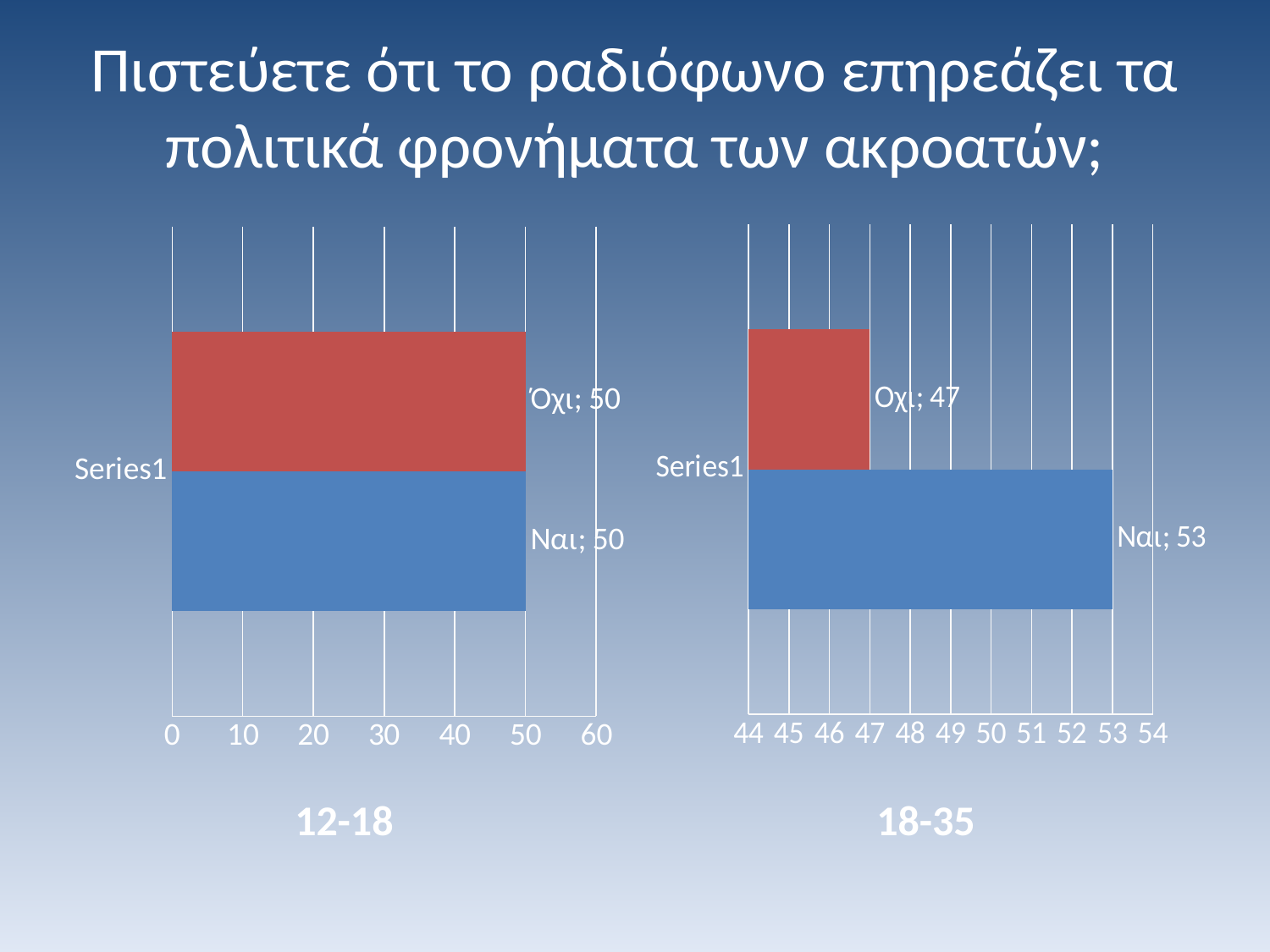
In the 18-35 chart, what is the value for Όχι? 47 In the 12-18 chart, what is the value for Ναι? 50 In the 18-35 chart, which category has the lowest value? Όχι What kind of chart is the 12-18 chart? Bar chart In the 18-35 chart, is the value for Όχι greater or less than 50? less In the 18-35 chart, what is the value for Ναι? 53 How many charts are shown on the slide? 2 In the 18-35 chart, which category has the highest value? Ναι In the 18-35 chart, is the value for Ναι greater or less than 50? greater In the 18-35 chart, what is the difference between the values for Ναι and Όχι? 6 In the 12-18 chart, what is the highest value shown on the horizontal axis? 60 In the 12-18 chart, what is the value for Όχι? 50